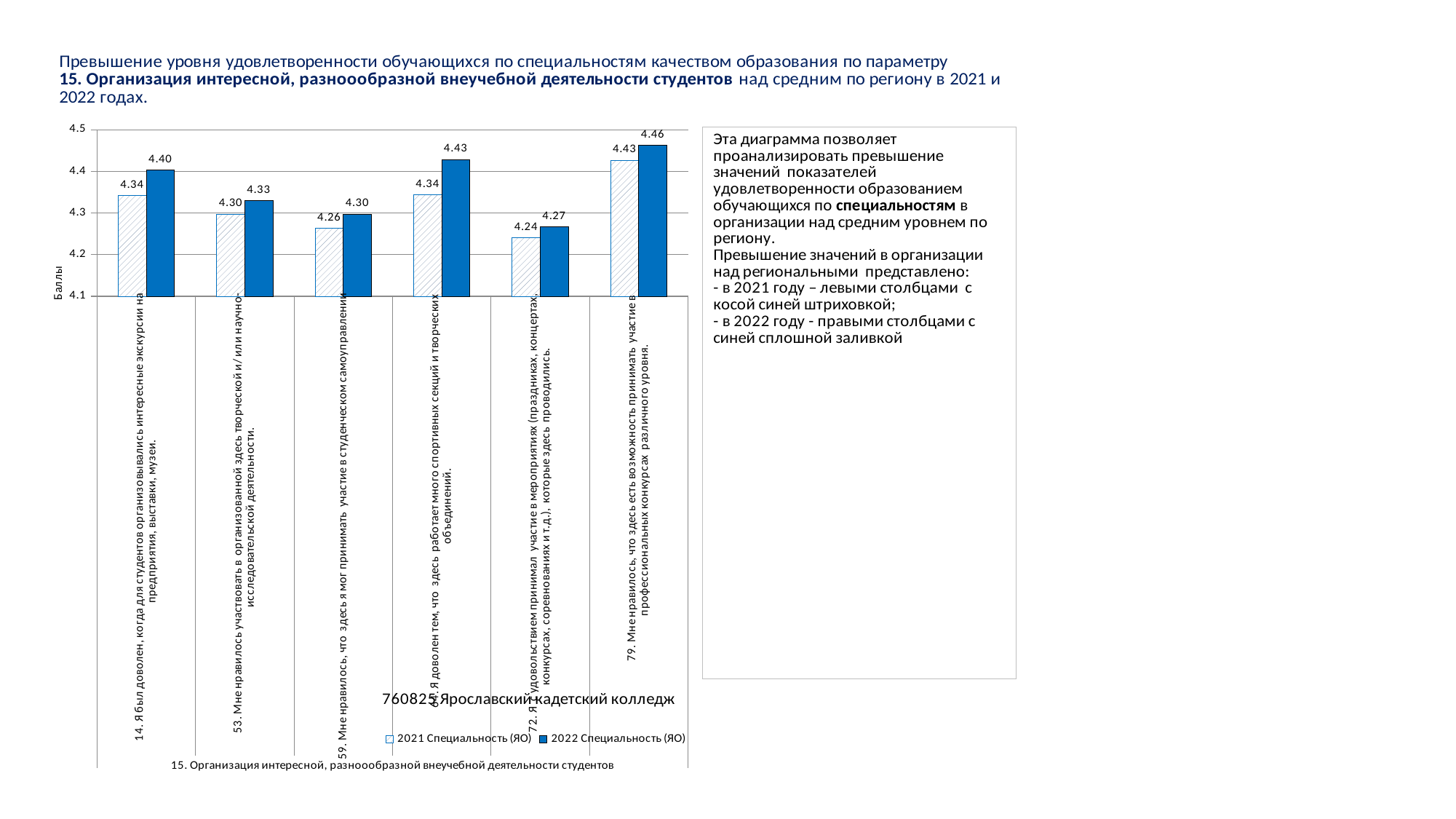
Which statement has the highest 2022 Специальность (ЯО) value? 79. Мне нравилось, что здесь есть возможность принимать участие в профессиональных конкурсах различного уровня What is the 2021 Специальность (ЯО) value for statement 53 (Мне нравилось участвовать в организованной здесь творческой и/или научно-исследовательской деятельности)? 4.30 How many categories (statements) are plotted on the chart? 6 What is the 2021 Специальность (ЯО) value for statement 59 (Мне нравилось, что здесь я мог принимать участие в студенческом самоуправлении)? 4.26 What type of chart is shown on the slide? bar chart Which is larger for statement 79 (участие в профессиональных конкурсах): the 2021 value or the 2022 value? 2022 value What is the label of the vertical axis of the chart? Баллы How many series does the chart legend list? 2 Which statement has the lowest 2021 Специальность (ЯО) value? 72. Я с удовольствием принимал участие в мероприятиях (праздниках, концертах, конкурсах, соревнованиях и т.д.), которые здесь проводились What is the title of the chart? 760825 Ярославский кадетский колледж What is the 2022 Специальность (ЯО) value for statement 14 (Я был доволен, когда для студентов организовывались интересные экскурсии)? 4.40 What is the difference between the 2022 and 2021 values for statement 14 (интересные экскурсии на предприятия, выставки, музеи)? 0.06